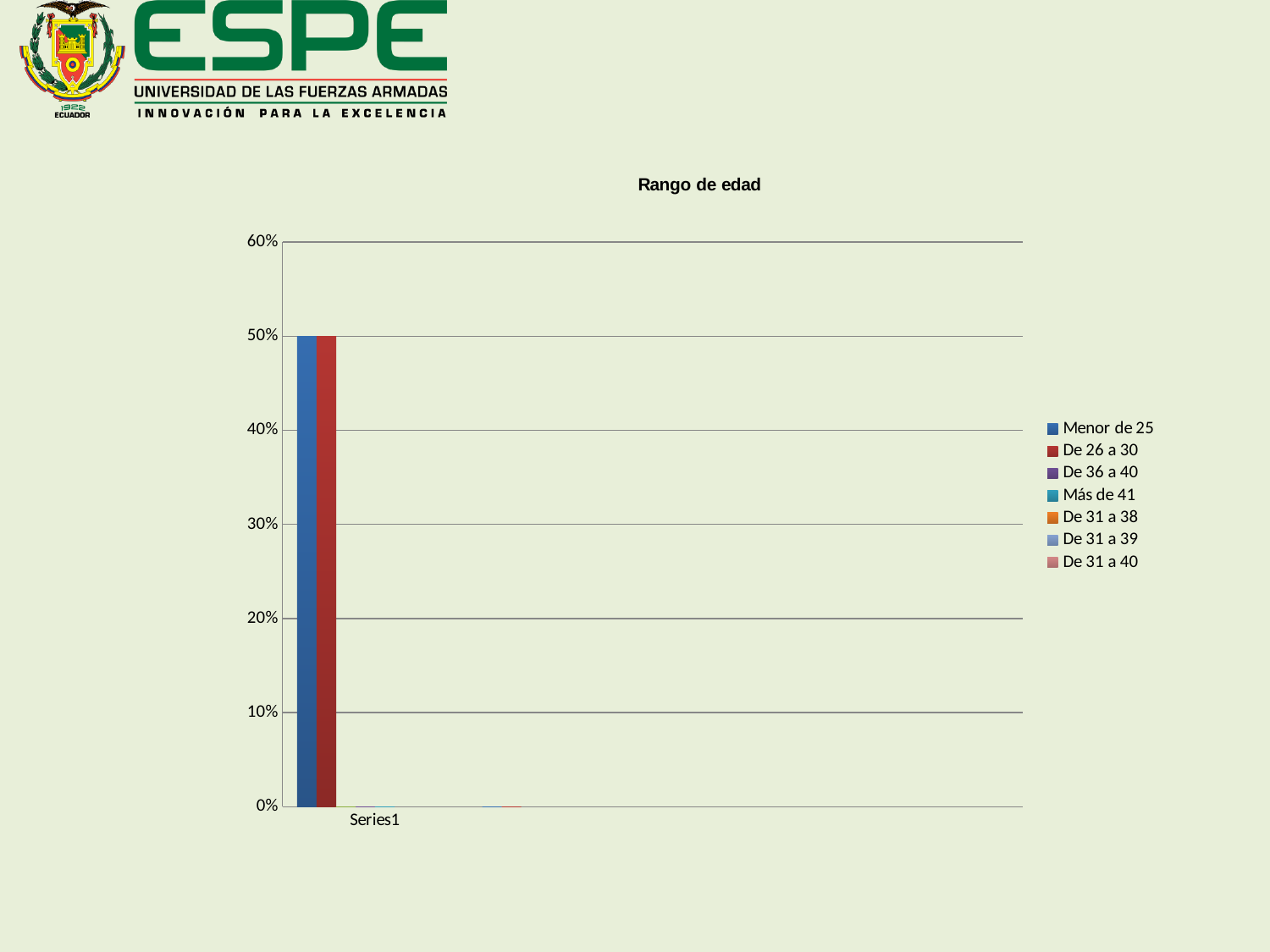
What kind of chart is shown on the slide? bar chart What is the highest value shown on the y axis? 60% How many categories are shown on the x axis? 1 What is the label of the category on the x axis? Series1 How many series does the legend list? 7 What is the value for De 26 a 30? 50% What is the difference between the values for Menor de 25 and De 26 a 30? 0% Is the value for De 26 a 30 greater or less than 60%? less What is the value for Menor de 25? 50% Is the value for Menor de 25 greater or less than 40%? greater What is the title of the chart? Rango de edad